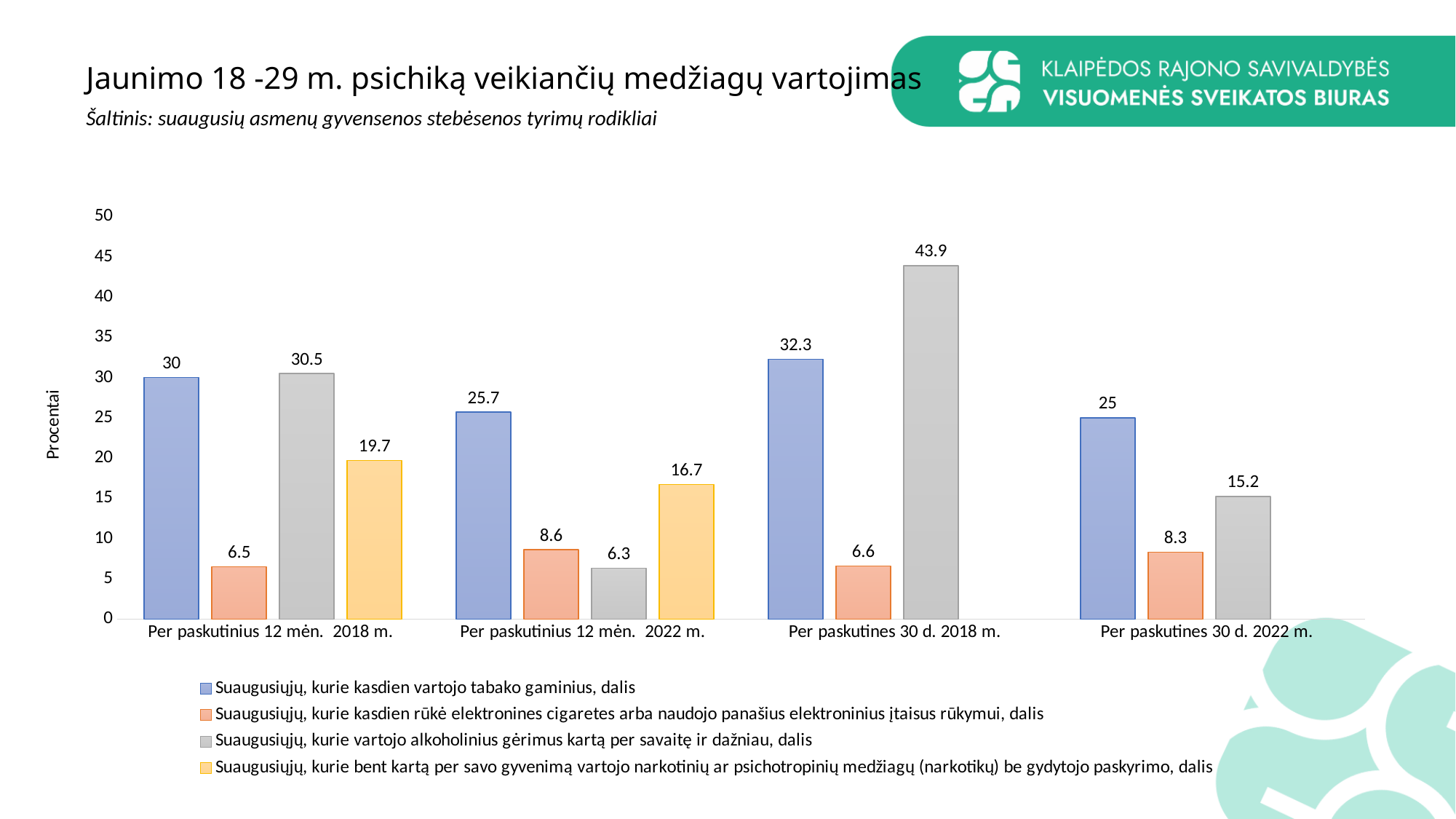
How many categories are shown on the x axis? 4 What is the value for daily tobacco users (Suaugusiųjų, kurie kasdien vartojo tabako gaminius) in the category 'Per paskutinius 12 mėn. 2018 m.'? 30 How many series does the legend list? 4 Which category has the lowest value for weekly-or-more alcohol users? Per paskutinius 12 mėn. 2022 m. Which is larger: the daily tobacco user value or the weekly-or-more alcohol user value in the category 'Per paskutinius 12 mėn. 2022 m.'? daily tobacco users (25.7) What is the difference between the daily tobacco user values for 'Per paskutines 30 d. 2018 m.' and 'Per paskutines 30 d. 2022 m.'? 7.3 What is the value for weekly-or-more alcohol users (Suaugusiųjų, kurie vartojo alkoholinius gėrimus kartą per savaitę ir dažniau) in the category 'Per paskutines 30 d. 2018 m.'? 43.9 Which category has the highest value for weekly-or-more alcohol users? Per paskutines 30 d. 2018 m. What type of chart is shown on the slide? bar chart What is the label of the y axis? Procentai What is the value for lifetime drug use (Suaugusiųjų, kurie bent kartą per savo gyvenimą vartojo narkotinių ar psichotropinių medžiagų) in the category 'Per paskutinius 12 mėn. 2018 m.'? 19.7 What is the value for daily e-cigarette users (Suaugusiųjų, kurie kasdien rūkė elektronines cigaretes) in the category 'Per paskutinius 12 mėn. 2022 m.'? 8.6